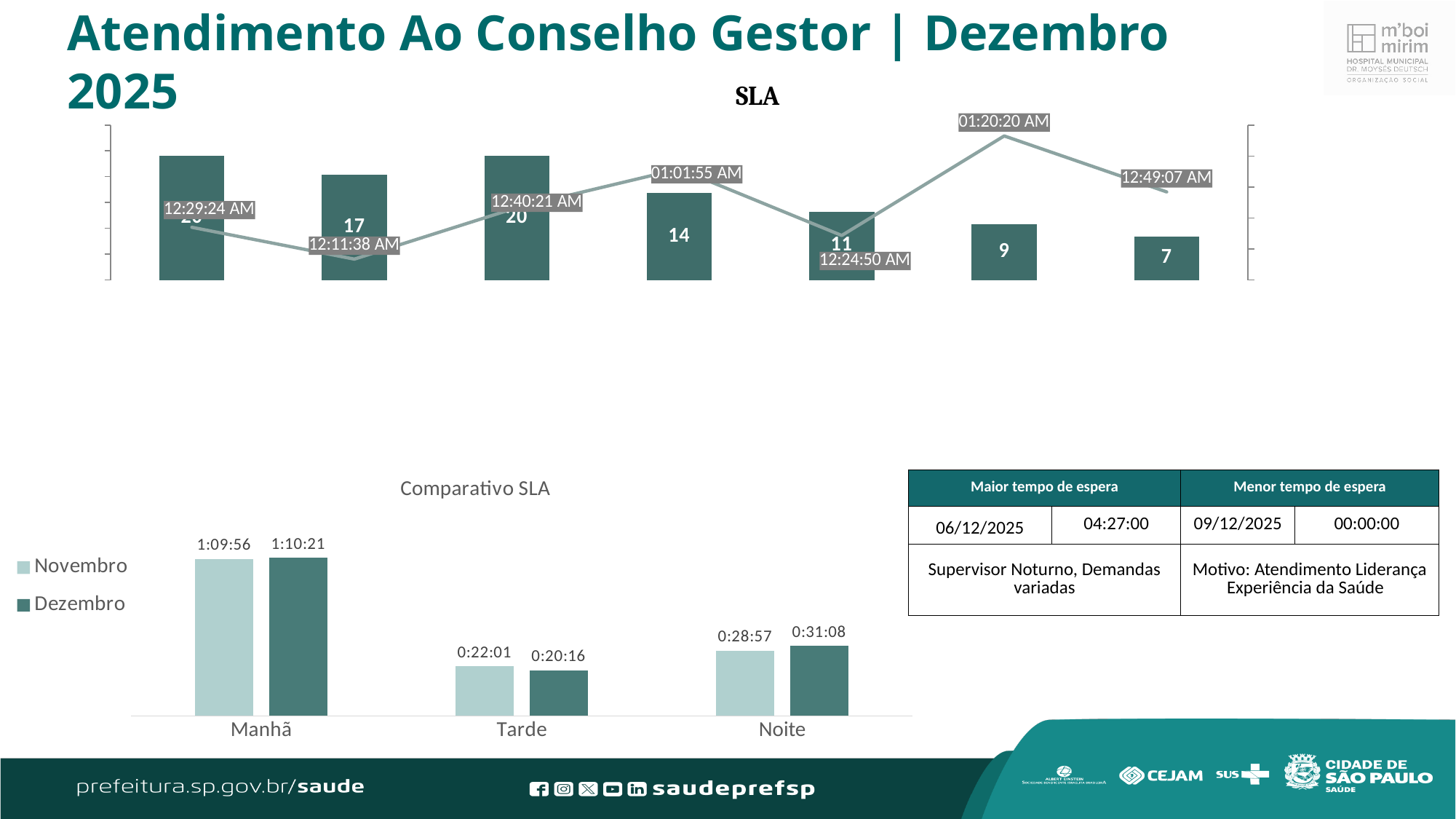
In the 'SLA' chart at the top of the slide, what is the value of the rightmost bar? 7 In the 'Comparativo SLA' chart, which category has the highest Dezembro value? Manhã In the 'Comparativo SLA' chart, how many series does the legend list? 2 In the 'Comparativo SLA' chart, what is the Novembro value for Manhã? 1:09:56 In the 'Comparativo SLA' chart, what is the Dezembro value for Tarde? 0:20:16 In the 'SLA' chart at the top of the slide, how many bars are plotted? 7 In the 'Comparativo SLA' chart, what is the difference between the Dezembro and Novembro values for Noite? 0:02:11 What kind of chart is the 'Comparativo SLA' chart? Bar chart In the 'Comparativo SLA' chart, what is the Dezembro value for Noite? 0:31:08 In the 'Comparativo SLA' chart, which is larger for Tarde: the Novembro value or the Dezembro value? Novembro In the 'Comparativo SLA' chart, which category has the lowest Novembro value? Tarde In the 'Comparativo SLA' chart, how many categories are shown on the x axis? 3